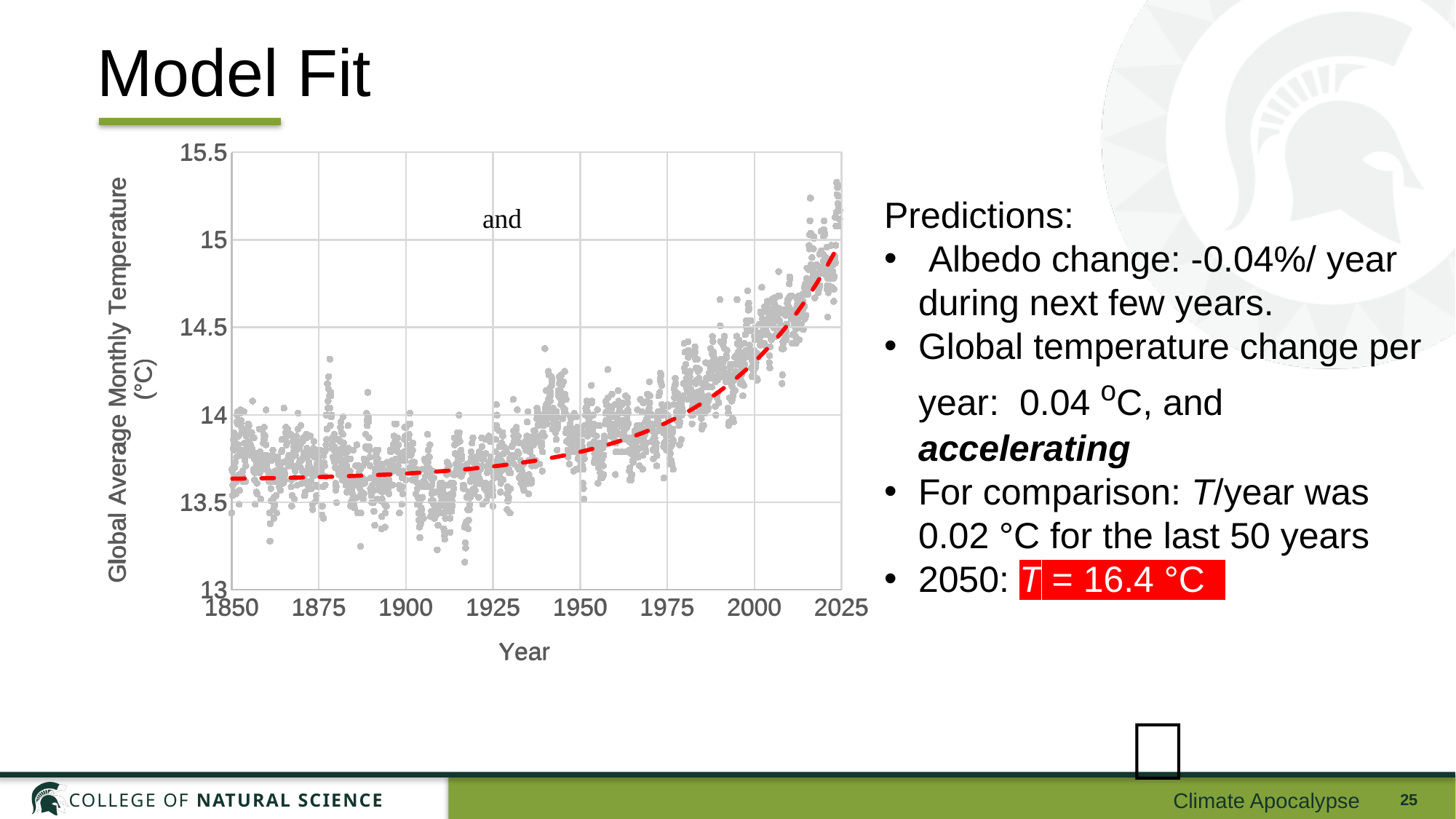
Is the value of the dashed fitted curve at 2000 greater or less than 14? greater Do the plotted temperatures rise or fall overall from 1850 to 2025? rise Is the value of the dashed fitted curve at 2025 greater or less than 14.5? greater What kind of chart is shown on the slide? scatter plot What is the label of the y axis of the chart? Global Average Monthly Temperature (°C) What is the highest value shown on the y axis of the chart? 15.5 Is the value of the dashed fitted curve at 1850 greater or less than 14? less Is the fitted curve value higher at 2025 or at 1850? 2025 Does the dashed fitted curve rise or fall between 1975 and 2025? rise What is the label of the x axis of the chart? Year